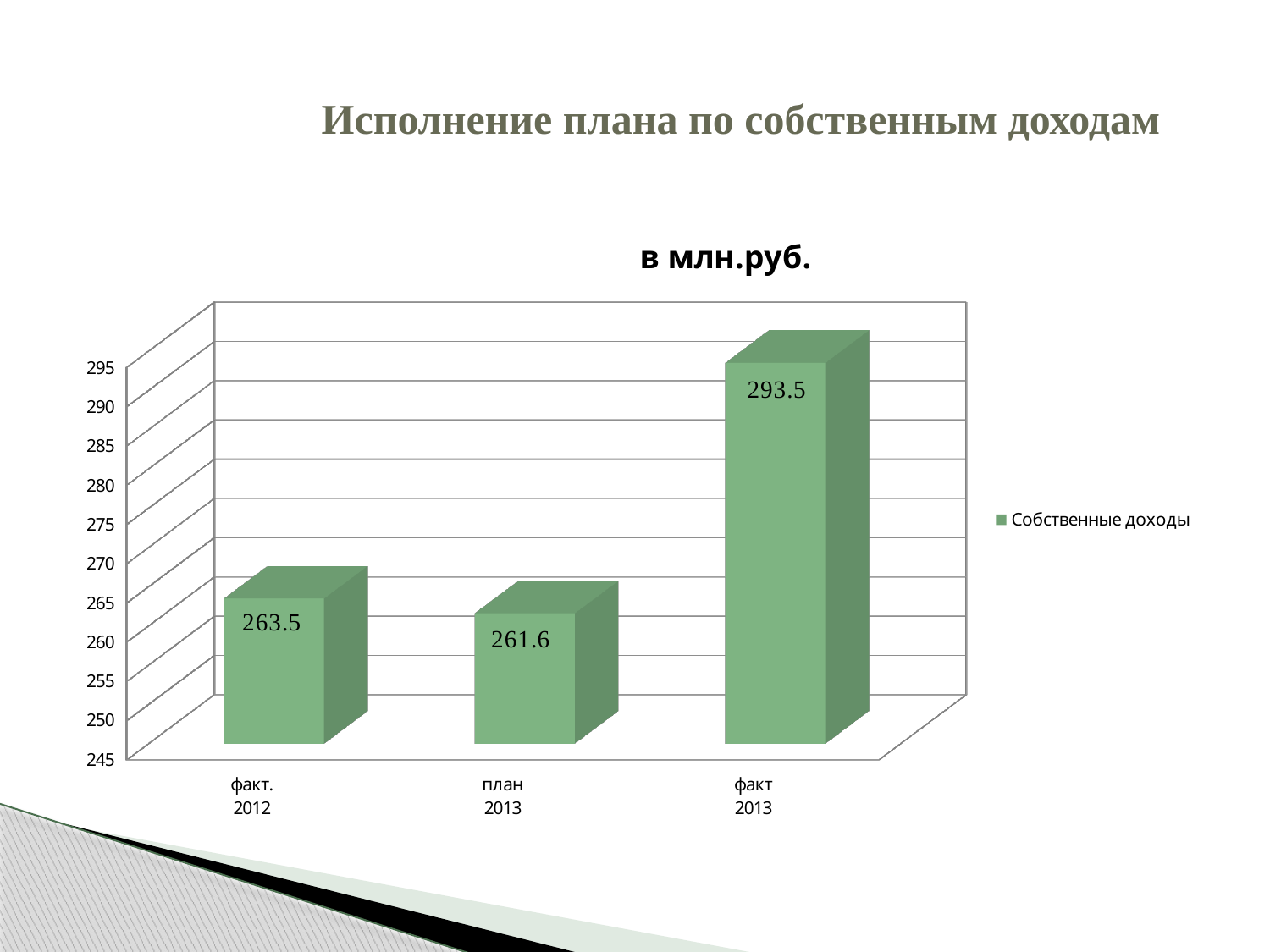
What kind of chart is shown on the slide? bar chart Is the value for факт 2013 greater or less than 290? greater What is the value for план 2013? 261.6 Which is larger, факт. 2012 or факт 2013? факт 2013 Which category has the lowest value? план 2013 What is the value for факт. 2012? 263.5 What is the value for факт 2013? 293.5 Which category has the highest value? факт 2013 What is the difference between факт 2013 and план 2013? 31.9 What series name does the legend list? Собственные доходы How many categories are shown on the x axis? 3 What is the difference between факт. 2012 and план 2013? 1.9